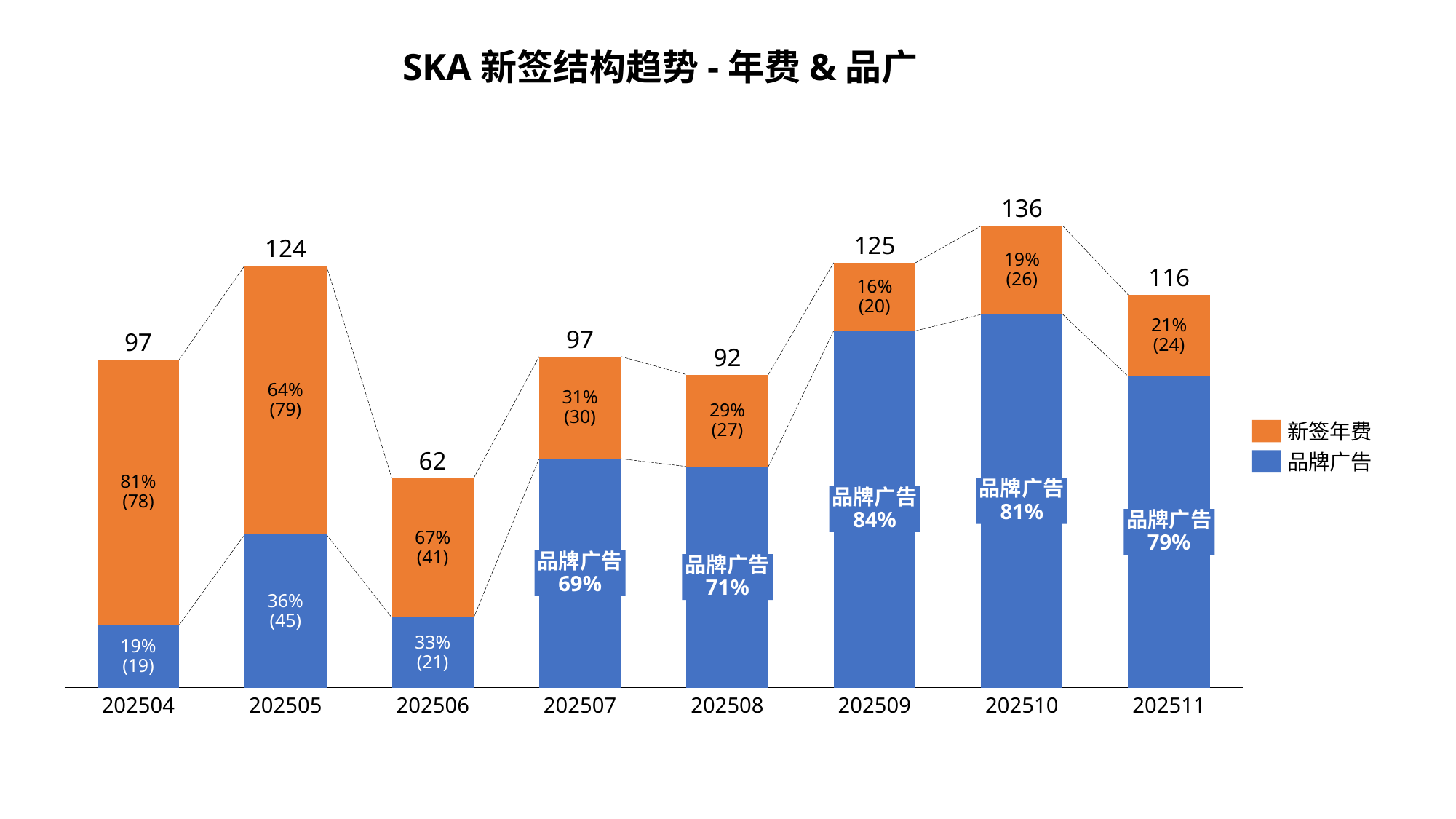
What is the 新签年费 value (in parentheses) for 202505? 79 How many series does the legend list? 2 How many months are shown on the x axis? 8 What kind of chart is this? Stacked bar chart Which month has the lowest total value? 202506 What is the total value shown above the bar for 202510? 136 What is the 品牌广告 value (in parentheses) for 202504? 19 Which series is shown in orange according to the legend? 新签年费 Which is larger, the total for 202505 or the total for 202509? 202509 What is the difference between the total for 202510 and the total for 202511? 20 What percentage does 品牌广告 account for in 202509? 84% Which month has the highest total value? 202510